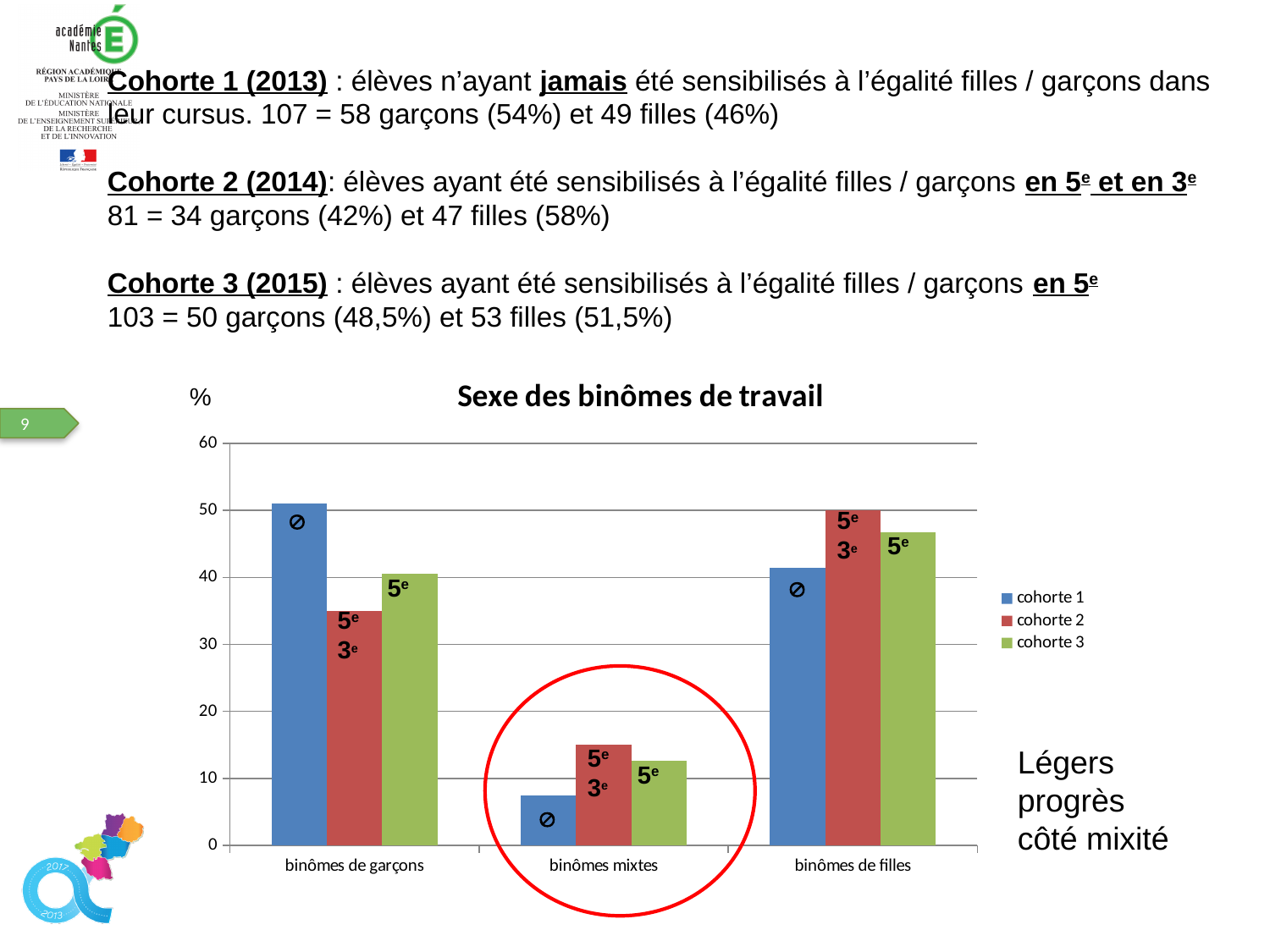
Is the value for cohorte 2 in binômes mixtes greater or less than 20? less What kind of chart is shown on the slide? bar chart Which category on the chart is circled in red? binômes mixtes What is the title of the chart? Sexe des binômes de travail For cohorte 1, which category has the lowest value? binômes mixtes For binômes de filles, which is larger: cohorte 1 or cohorte 2? cohorte 2 For cohorte 1, which category has the highest value? binômes de garçons For binômes mixtes, which cohort has the highest value? cohorte 2 How many categories are shown on the x axis of the chart? 3 How many series does the chart legend list? 3 Is the value for cohorte 2 in binômes de garçons greater or less than 40? less For binômes de garçons, which is larger: cohorte 1 or cohorte 2? cohorte 1